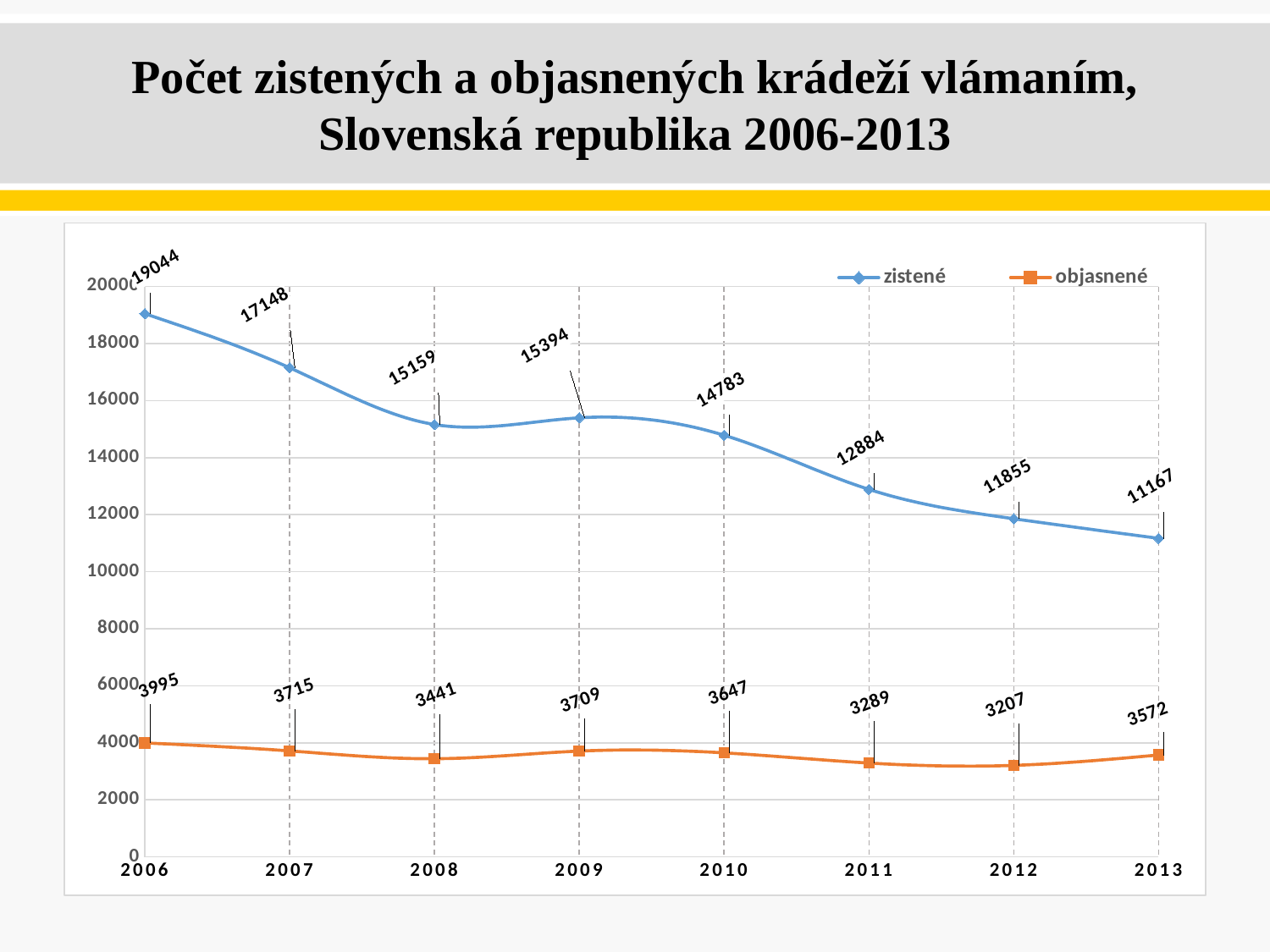
In which year is the zistené series lowest? 2013 What is the difference between the zistené values in 2006 and 2013? 7877 Which is larger, the objasnené value in 2009 or in 2010? 2009 In which year is the objasnené series highest? 2006 How many years are shown on the x axis? 8 What is the value of the zistené series in 2009? 15394 What is the value of the objasnené series in 2013? 3572 Does the zistené series generally rise or fall from 2006 to 2013? fall In which year is the objasnené series lowest? 2012 How many series does the legend list? 2 What is the value of the zistené series in 2006? 19044 What kind of chart is shown on the slide? line chart